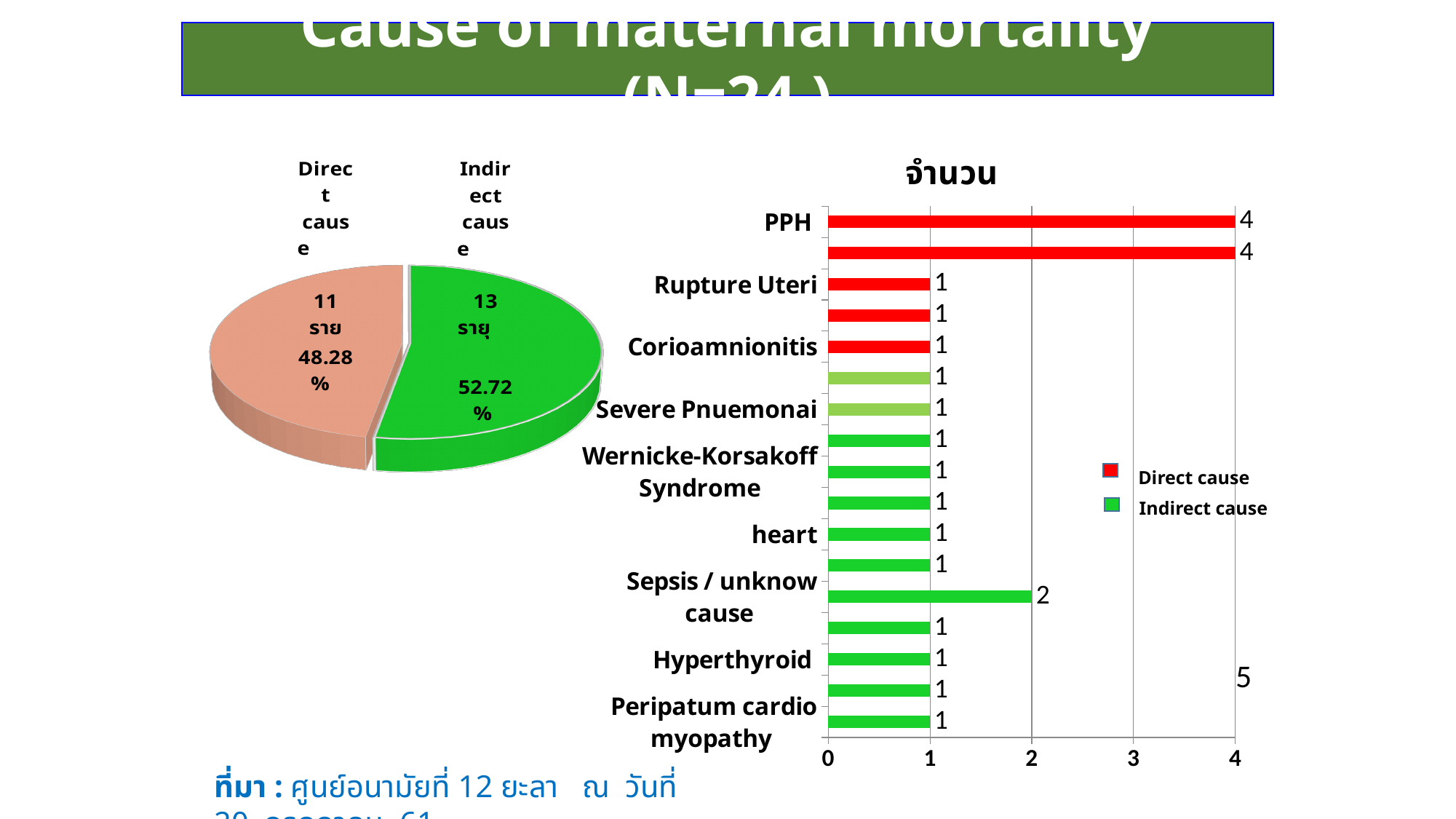
What kind of chart is the chart on the right of the slide? bar chart In the bar chart titled จำนวน, what is the value for Hyperthyroid? 1 In the bar chart titled จำนวน, what is the difference between the values for PPH and Rupture Uteri? 3 In the bar chart titled จำนวน, what is the value for PPH? 4 How many series does the legend of the bar chart titled จำนวน list? 2 In the pie chart, which slice is larger, Direct cause or Indirect cause? Indirect cause In the bar chart titled จำนวน, which is larger, the value for Sepsis / unknow cause or the value for heart? Sepsis / unknow cause In the bar chart titled จำนวน, what is the value for Sepsis / unknow cause? 2 In the pie chart, what percentage is shown for Direct cause? 48.28% What kind of chart is the chart on the left of the slide? pie chart In the bar chart titled จำนวน, what colour represents Direct cause in the legend? red In the pie chart, how many cases (ราย) are shown for Indirect cause? 13